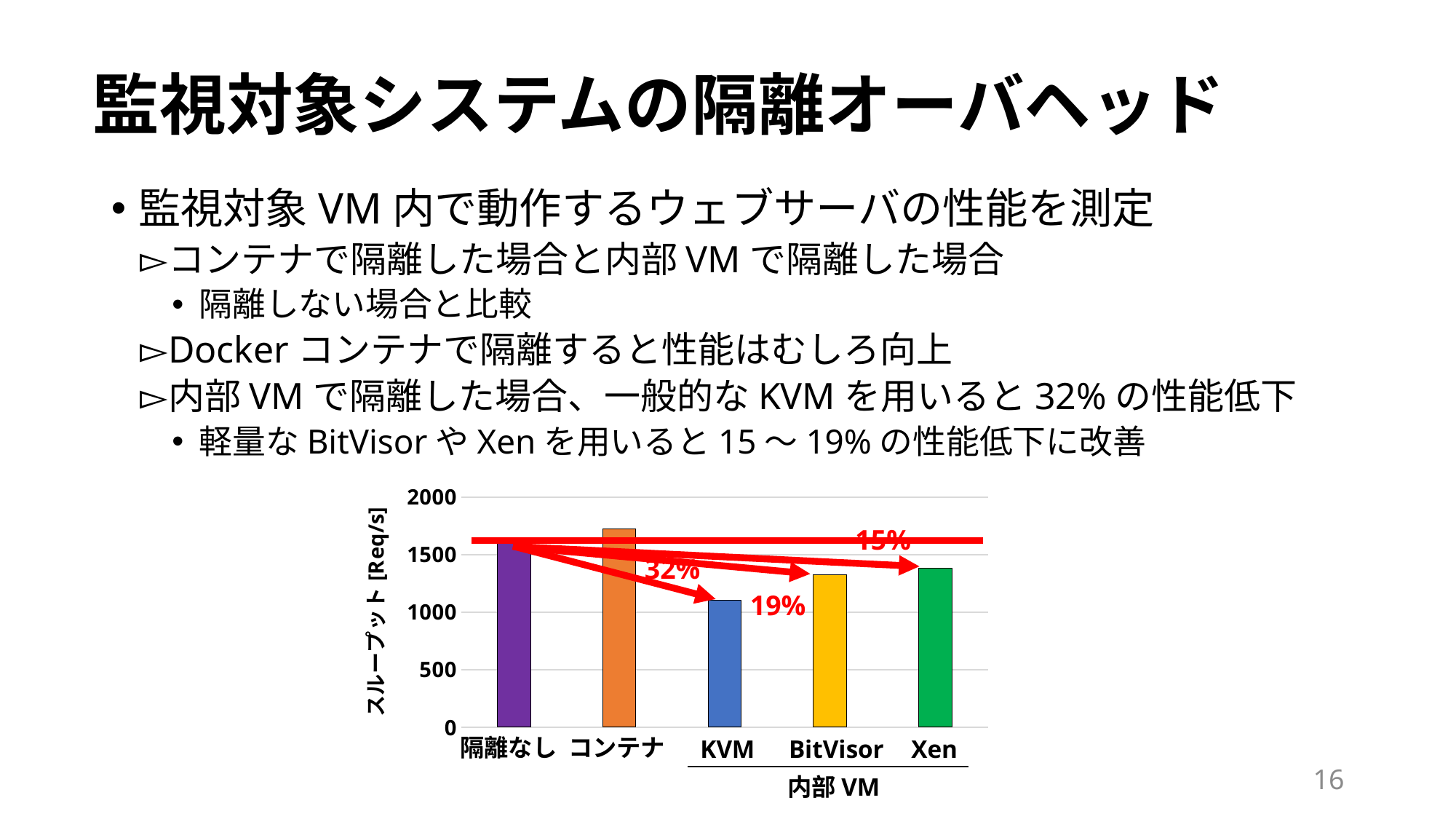
What percentage drop is annotated on the arrow pointing to the KVM bar? 32% Is the value for KVM greater or less than 1500? less Which has the higher throughput, コンテナ or BitVisor? コンテナ How many bars (categories) does the chart show? 5 Which has the higher throughput, 隔離なし or KVM? 隔離なし What kind of chart is shown on the slide? bar chart Is the value for BitVisor greater or less than 1000? greater Which category has the lowest throughput? KVM What is the label of the vertical axis? スループット [Req/s] Is the value for コンテナ greater or less than 1500? greater Which category has the highest throughput? コンテナ